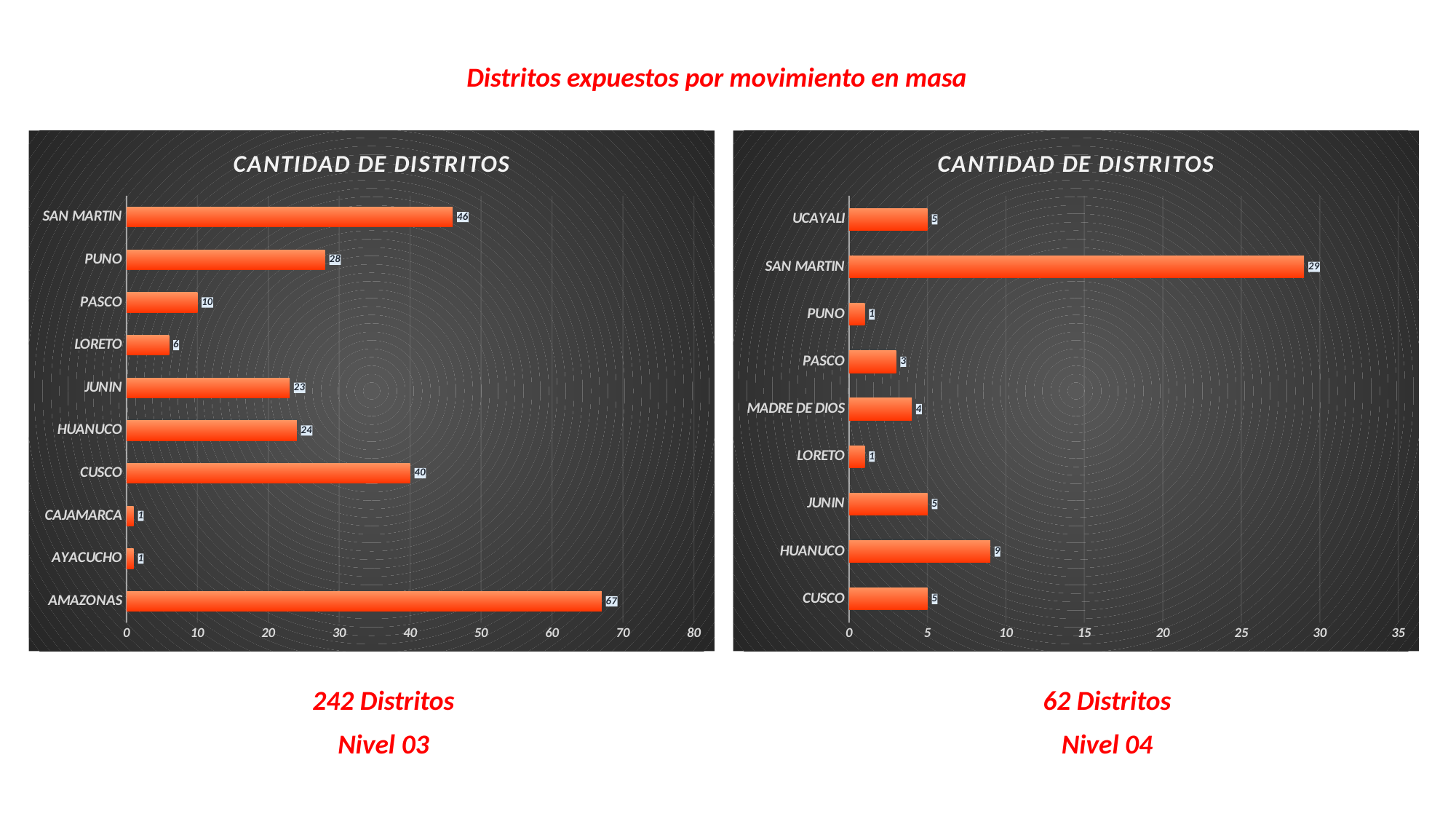
How many categories are shown in the left chart (Nivel 03)? 10 In the right chart (Nivel 04), what is the value for HUANUCO? 9 In the right chart (Nivel 04), what is the difference between the values for SAN MARTIN and HUANUCO? 20 In the right chart (Nivel 04), which category has the highest value? SAN MARTIN How many categories are shown in the right chart (Nivel 04)? 9 In the right chart (Nivel 04), what is the value for SAN MARTIN? 29 What type of chart is the left chart (Nivel 03)? Bar chart In the left chart (Nivel 03), what is the value for AMAZONAS? 67 In the left chart (Nivel 03), what is the difference between the values for SAN MARTIN and PUNO? 18 In the left chart (Nivel 03), which is larger, the value for HUANUCO or the value for PASCO? HUANUCO In the left chart (Nivel 03), which category has the highest value? AMAZONAS In the left chart (Nivel 03), what is the value for CUSCO? 40